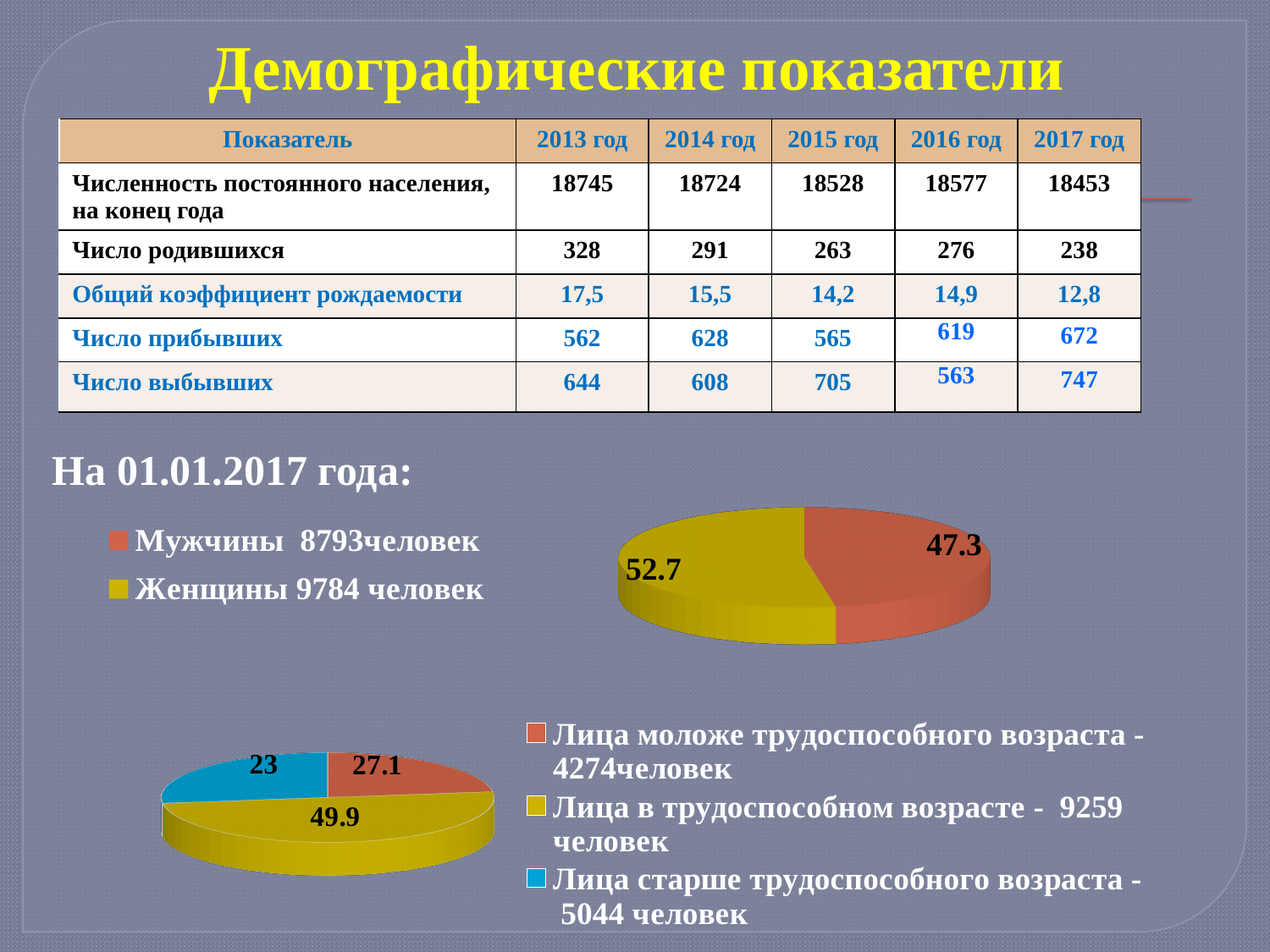
In the upper pie chart, which slice is larger, Мужчины or Женщины? Женщины In the upper pie chart, what is the difference between the Женщины and Мужчины values? 5.4 In the lower pie chart, which category has the largest slice? Лица в трудоспособном возрасте In the upper pie chart, what value is shown for the Мужчины slice? 47.3 How many entries does the legend of the upper pie chart list? 2 What kind of chart is the upper chart on the slide? pie chart In the lower pie chart, what colour is the slice for Лица старше трудоспособного возраста? blue In the upper pie chart, what value is shown for the Женщины slice? 52.7 In the lower pie chart, what value is shown for Лица старше трудоспособного возраста? 23 How many slices does the lower pie chart have? 3 In the lower pie chart, what value is shown for Лица в трудоспособном возрасте? 49.9